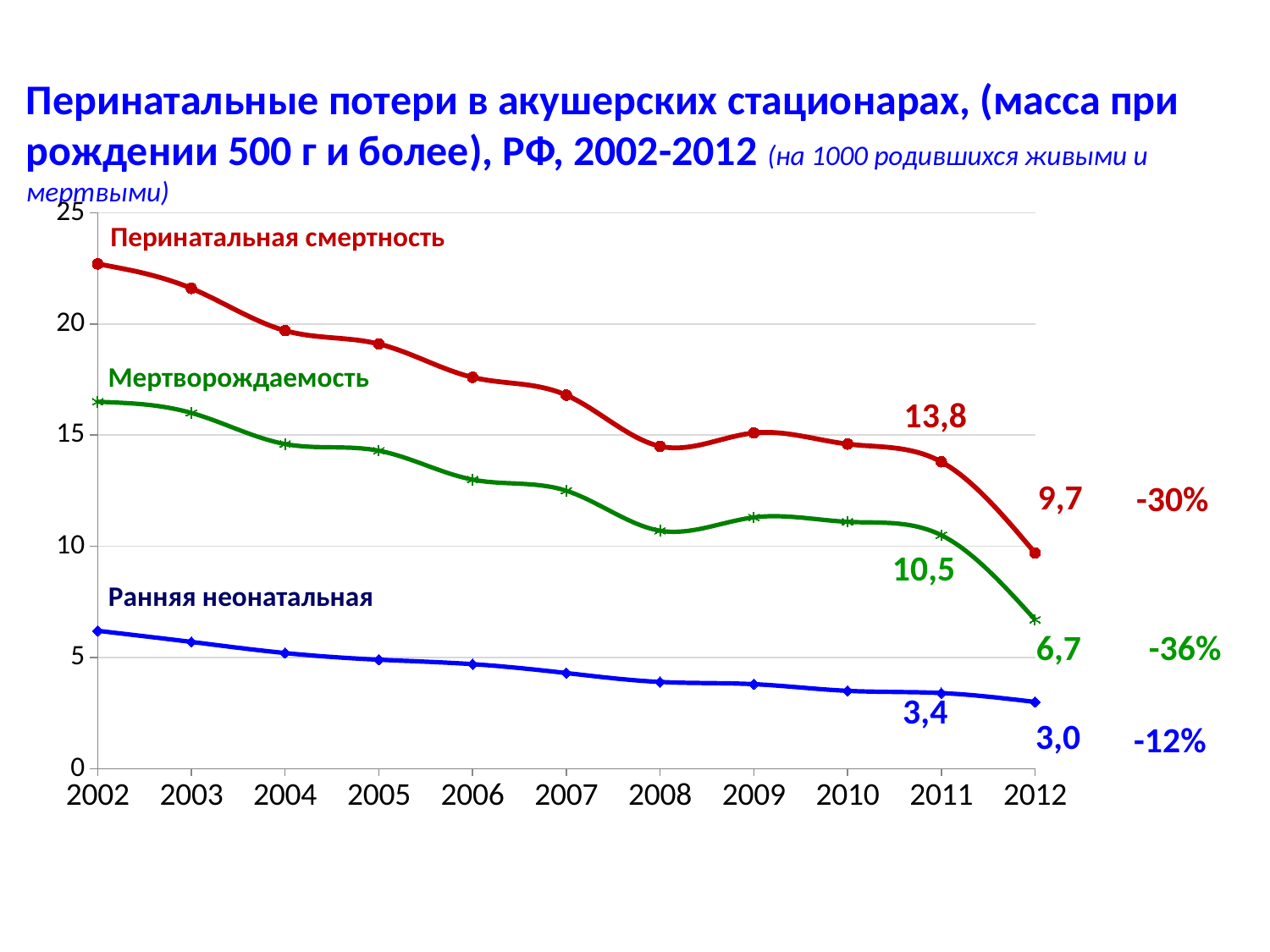
Which series has the lowest value in 2002? Ранняя неонатальная Which series has the highest value in 2012? Перинатальная смертность Is the value for Перинатальная смертность in 2002 greater or less than 20? greater What is the value for Ранняя неонатальная in 2012? 3,0 What is the value for Мертворождаемость in 2011? 10,5 What kind of chart is shown on the slide? line chart What is the value for Перинатальная смертность in 2012? 9,7 How many years are shown on the x axis? 11 By how much did Перинатальная смертность fall from 2011 (13,8) to 2012 (9,7)? 4,1 What is the difference between the 2011 and 2012 values of Ранняя неонатальная? 0,4 Is the value for Мертворождаемость in 2008 greater or less than 15? less What percentage change is shown next to the Мертворождаемость line? -36%